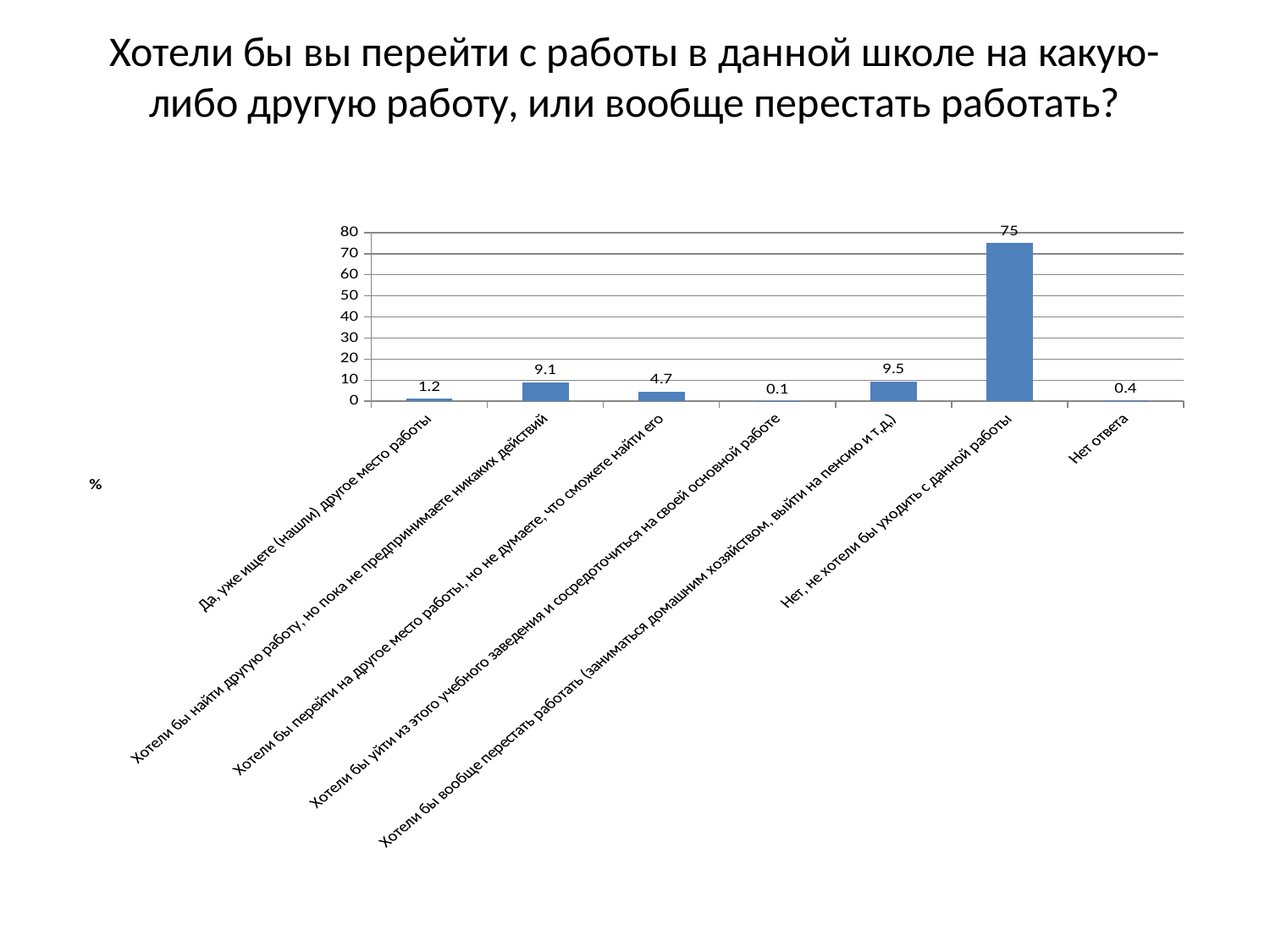
Which category has the lowest value? Хотели бы уйти из этого учебного заведения и сосредоточиться на своей основной работе What is the value for "Нет, не хотели бы уходить с данной работы"? 75 How many categories are shown on the x axis? 7 Is the value for "Нет, не хотели бы уходить с данной работы" greater or less than 70? greater What kind of chart is shown on the slide? bar chart Which category has the highest value? Нет, не хотели бы уходить с данной работы What is the value for "Нет ответа"? 0.4 What is the value for "Да, уже ищете (нашли) другое место работы"? 1.2 What is the value for "Хотели бы перейти на другое место работы, но не думаете, что сможете найти его"? 4.7 Which is larger: the value for "Хотели бы найти другую работу, но пока не предпринимаете никаких действий" or the value for "Хотели бы перейти на другое место работы, но не думаете, что сможете найти его"? Хотели бы найти другую работу, но пока не предпринимаете никаких действий What is the difference between the value for "Хотели бы найти другую работу, но пока не предпринимаете никаких действий" and the value for "Да, уже ищете (нашли) другое место работы"? 7.9 What is the difference between the value for "Нет, не хотели бы уходить с данной работы" and the value for "Хотели бы вообще перестать работать (заниматься домашним хозяйством, выйти на пенсию и т.д.)"? 65.5